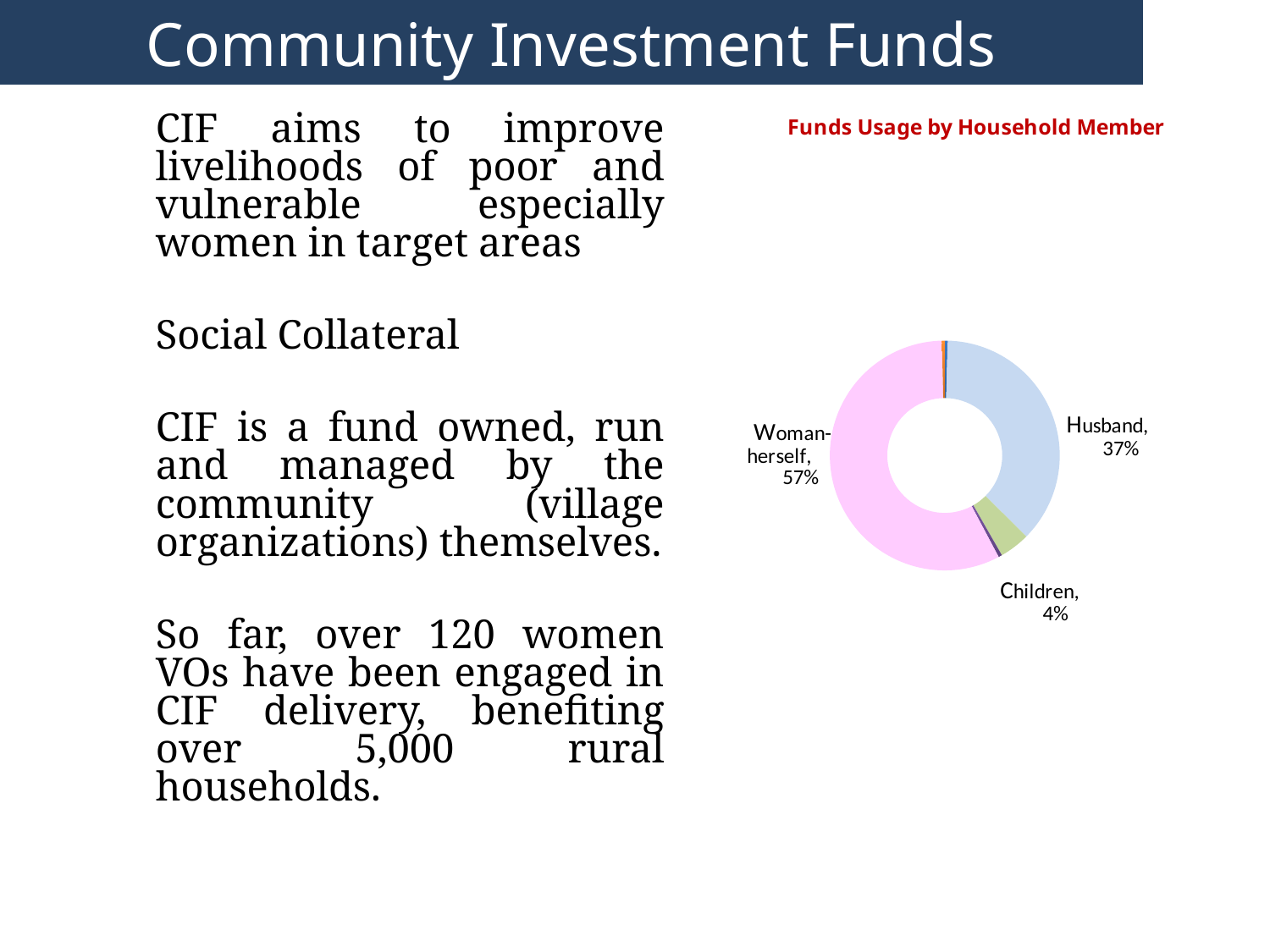
What percentage of funds usage is attributed to the husband? 37% What is the difference between the Husband share and the Children share? 33 percentage points Which household member accounts for the largest share of funds usage? Woman-herself What kind of chart is shown on the slide? Doughnut (pie) chart What is the title of the chart? Funds Usage by Household Member Which is larger, the share for Husband or the share for Children? Husband What colour is the Woman-herself slice in the chart? Pink How many percentage points larger is the Woman-herself share than the Husband share? 20 percentage points Which is larger, the share for Woman-herself or the share for Husband? Woman-herself What percentage of funds usage is attributed to children? 4% What share of funds usage is attributed to the woman herself? 57%